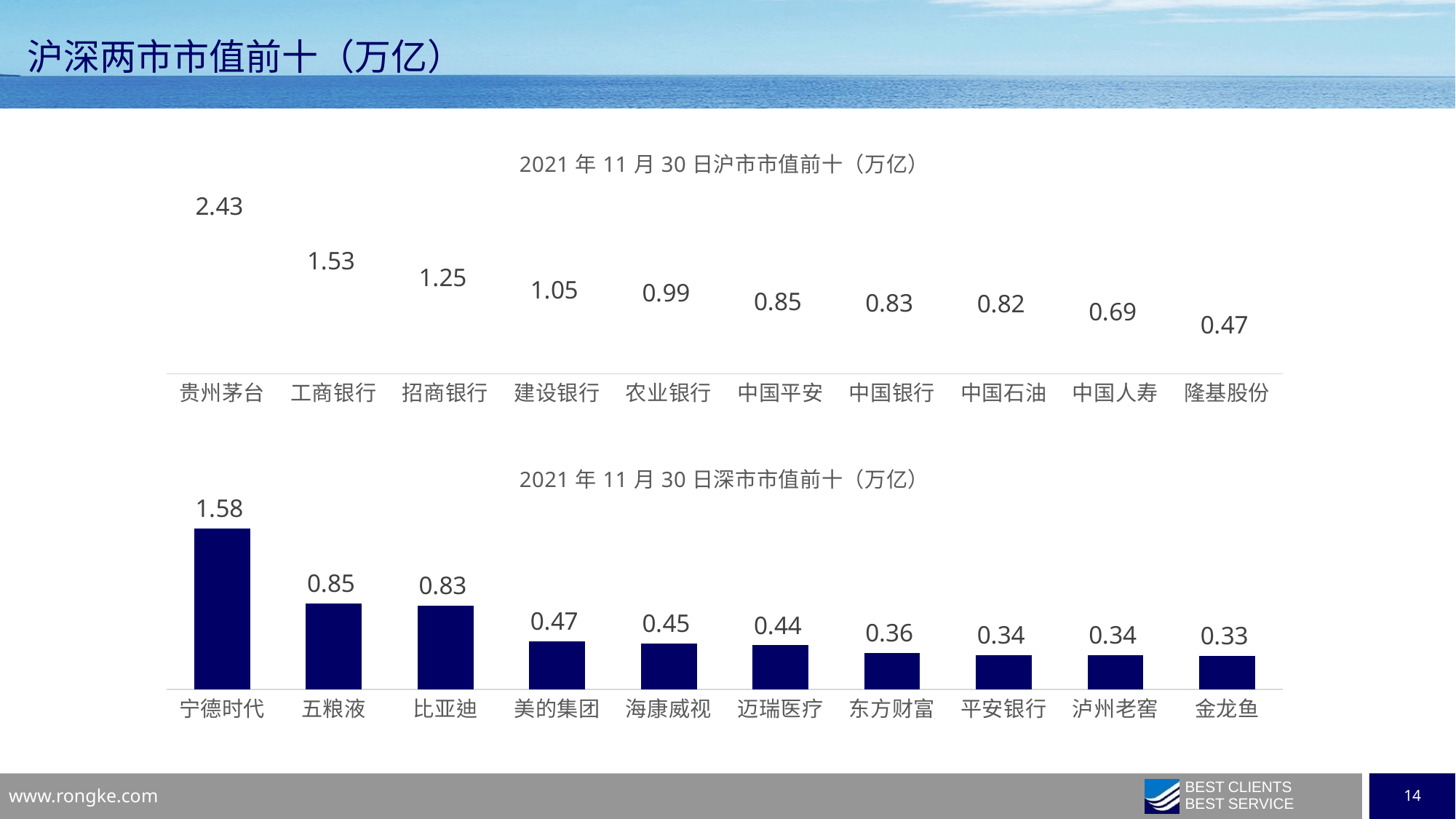
In the top chart (2021年11月30日沪市市值前十), what is the value for 中国石油? 0.82 In the top chart (2021年11月30日沪市市值前十), what is the difference between 工商银行 and 招商银行? 0.28 In the bottom chart (2021年11月30日深市市值前十), what is the value for 宁德时代? 1.58 In the bottom chart (2021年11月30日深市市值前十), which is larger, 五粮液 or 美的集团? 五粮液 In the bottom chart (2021年11月30日深市市值前十), what is the difference between 宁德时代 and 比亚迪? 0.75 In the bottom chart (2021年11月30日深市市值前十), do the values rise or fall from left to right? fall In the bottom chart (2021年11月30日深市市值前十), what is the value for 迈瑞医疗? 0.44 What kind of chart is the bottom chart (2021年11月30日深市市值前十)? bar chart In the top chart (2021年11月30日沪市市值前十), how many companies are shown? 10 In the bottom chart (2021年11月30日深市市值前十), which company has the highest value? 宁德时代 In the top chart (2021年11月30日沪市市值前十), what is the value for 贵州茅台? 2.43 In the top chart (2021年11月30日沪市市值前十), which company has the lowest value? 隆基股份